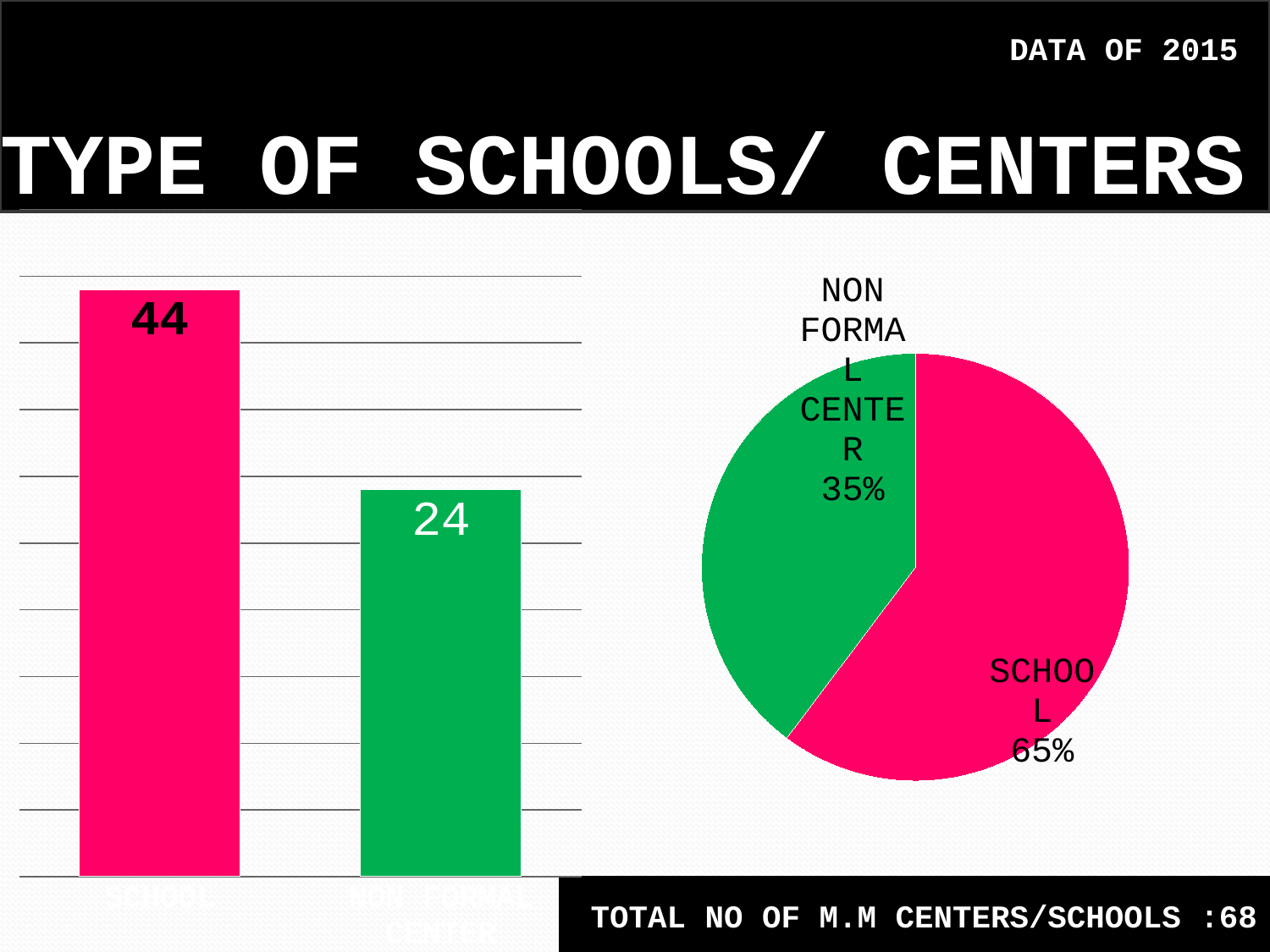
In the pie chart on the right, which slice is the largest? SCHOOL What kind of chart is on the left side of the slide? Bar chart In the bar chart on the left, which is larger: SCHOOL or NON FORMAL CENTER? SCHOOL In the pie chart on the right, what share does SCHOOL have? 65% How many bars are in the bar chart on the left? 2 In the bar chart on the left, which category has the highest value? SCHOOL In the pie chart on the right, what share does NON FORMAL CENTER have? 35% In the bar chart on the left, what is the value for NON FORMAL CENTER? 24 In the bar chart on the left, what is the value for SCHOOL? 44 What kind of chart is on the right side of the slide? Pie chart In the bar chart on the left, what is the difference between the SCHOOL value and the NON FORMAL CENTER value? 20 In the bar chart on the left, which category has the lowest value? NON FORMAL CENTER